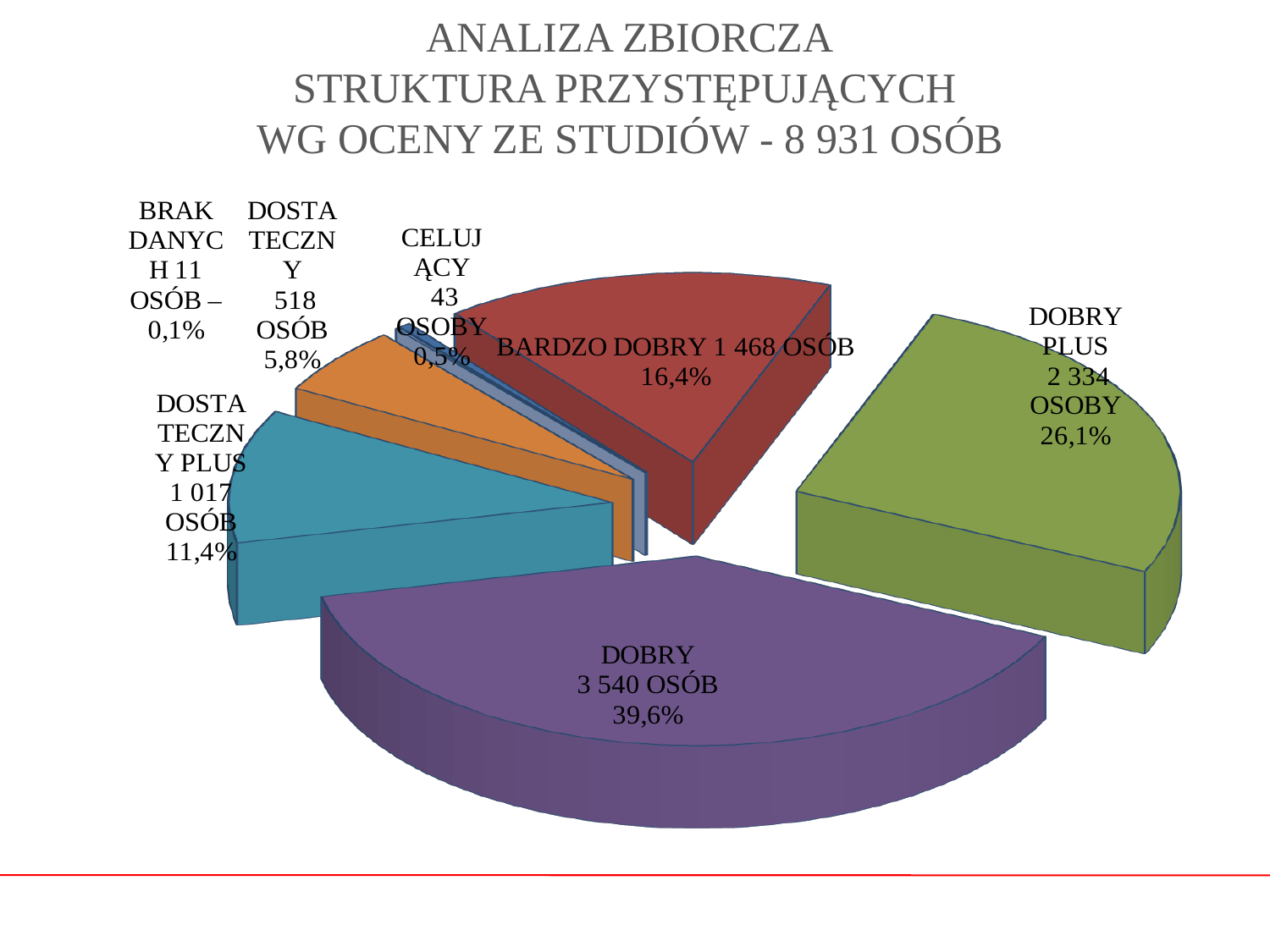
Which category has the smallest slice of the pie? BRAK DANYCH Which category has more people, DOSTATECZNY or CELUJĄCY? DOSTATECZNY What is the difference in number of people between DOBRY and DOBRY PLUS? 1 206 What kind of chart is shown on the slide? pie chart According to the title, how many people in total does the chart cover? 8 931 What percentage share does the DOBRY slice have? 39,6% Which category has the largest slice of the pie? DOBRY What percentage share does the DOSTATECZNY slice have? 5,8% How many categories (slices) does the pie chart have? 7 How many people are in the DOBRY PLUS category? 2 334 What percentage share does the BARDZO DOBRY slice have? 16,4% How many people are in the DOSTATECZNY PLUS category? 1 017